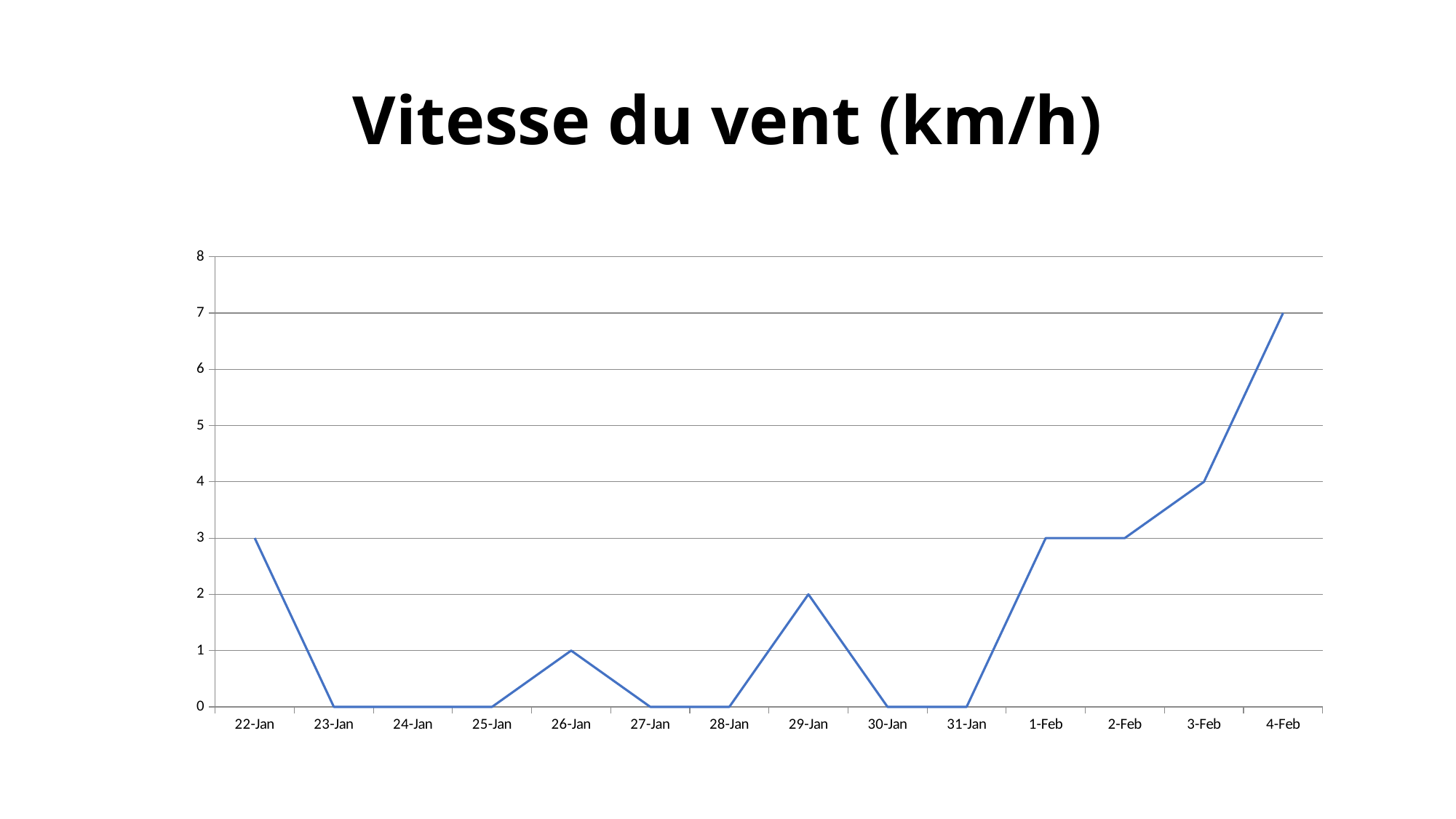
Which date has the highest wind speed? 4-Feb What type of chart is shown on the slide? line chart What is the wind speed value for 3-Feb? 4 Which is larger, the wind speed on 26-Jan or on 29-Jan? 29-Jan What is the wind speed value for 29-Jan? 2 What is the difference between the wind speed on 4-Feb and on 3-Feb? 3 Do the values rise or fall from 31-Jan to 4-Feb? rise How many dates are plotted along the x axis? 14 What is the wind speed value for 22-Jan? 3 What is the title of the chart? Vitesse du vent (km/h) What is the wind speed value for 4-Feb? 7 Is the wind speed on 4-Feb greater or less than 5? greater